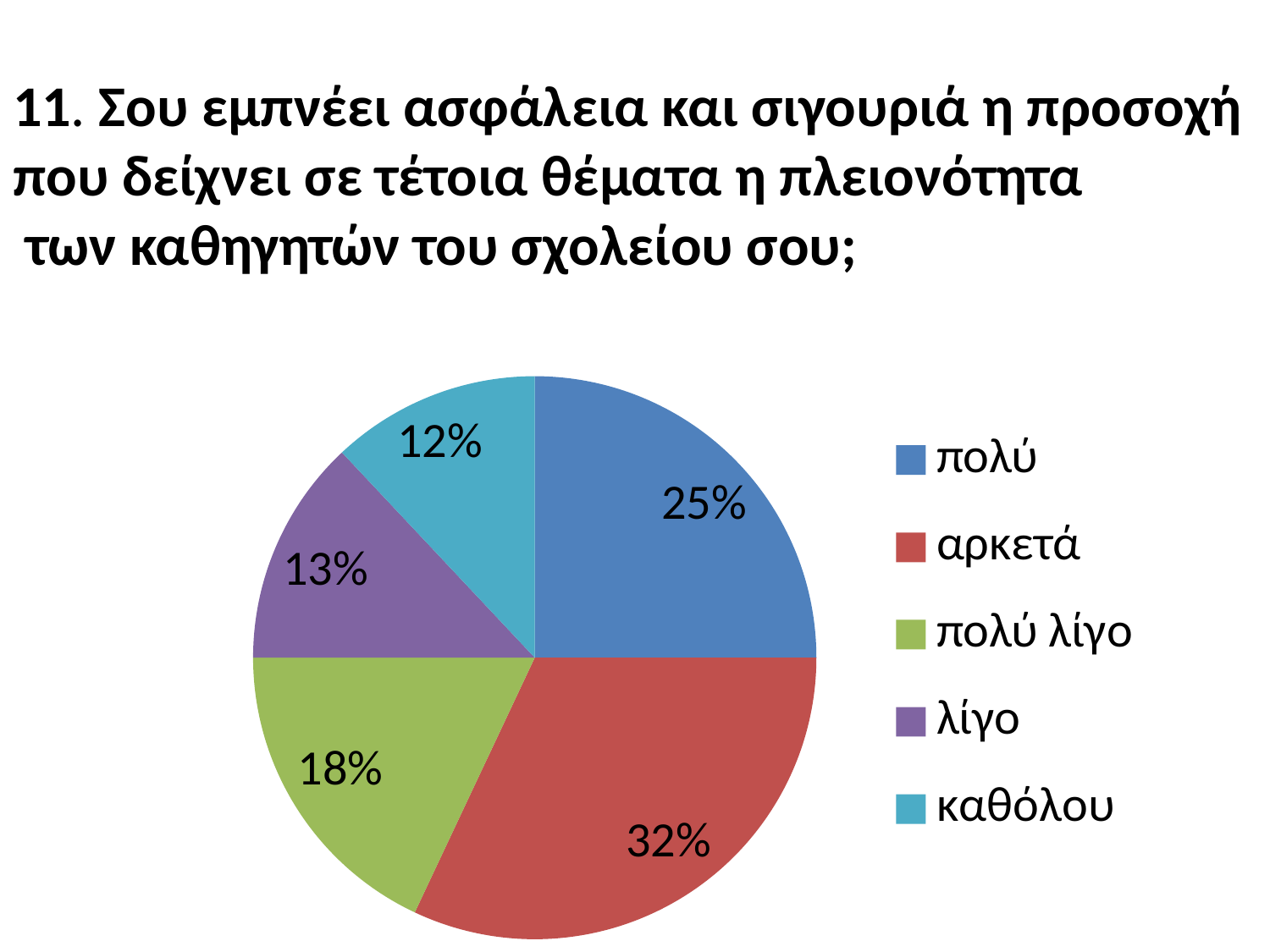
What is the difference in percentage points between "αρκετά" and "πολύ"? 7 Which is larger, the slice for "πολύ λίγο" or the slice for "λίγο"? πολύ λίγο What colour is the slice for "αρκετά" in the pie chart? red What type of chart is shown on the slide? pie chart What percentage of the pie chart corresponds to "αρκετά"? 32% What percentage of the pie chart corresponds to "πολύ λίγο"? 18% What percentage of the pie chart corresponds to "πολύ"? 25% Which category has the largest slice of the pie chart? αρκετά What percentage of the pie chart corresponds to "καθόλου"? 12% How many categories does the pie chart show? 5 Which category has the smallest slice of the pie chart? καθόλου What percentage of the pie chart corresponds to "λίγο"? 13%